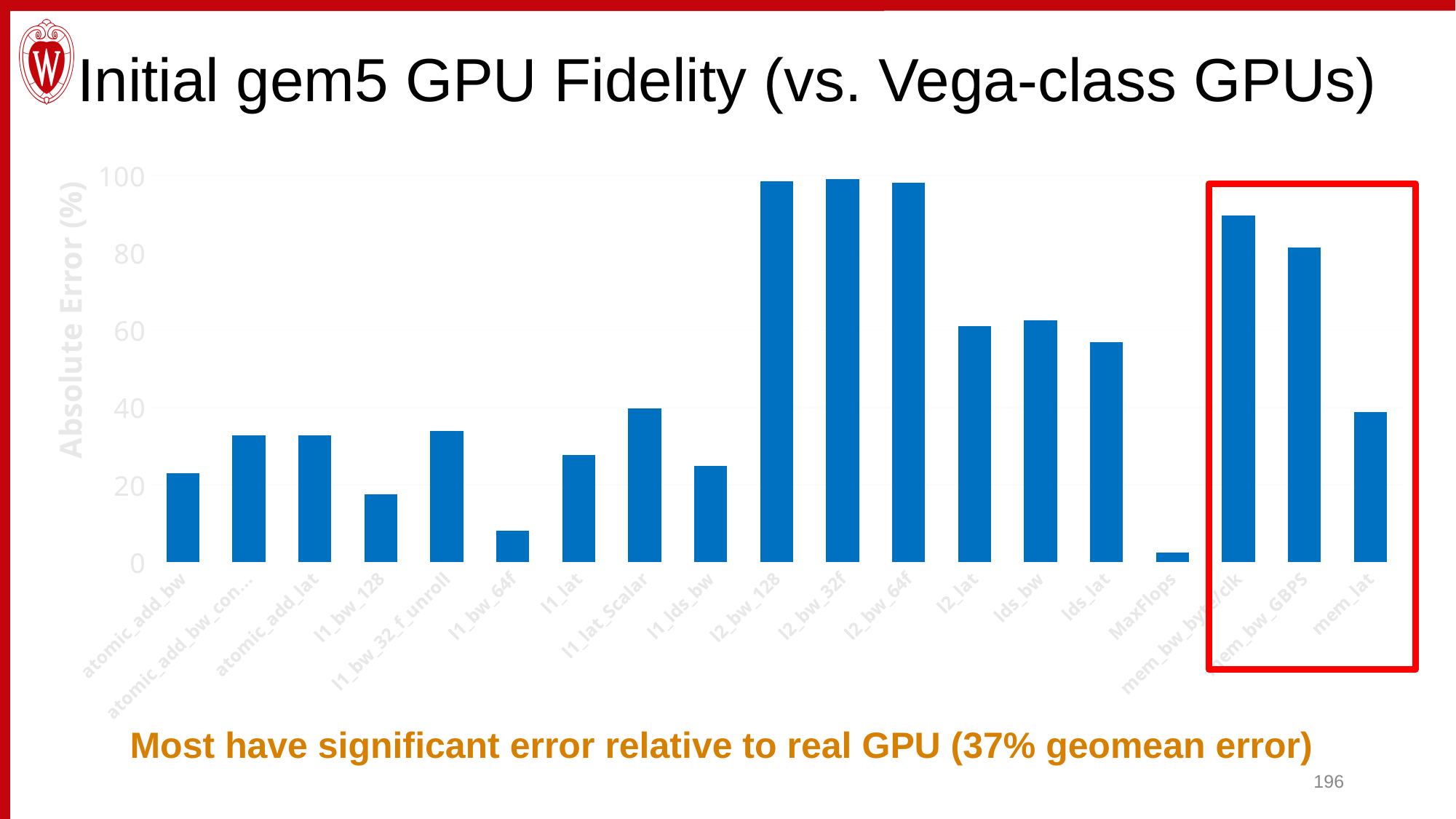
Is the value for l2_bw_32f greater or less than 80? greater Which has a larger absolute error, l1_bw_128 or l2_lat? l2_lat How many bars are enclosed by the red box on the right of the chart? 3 What is the label of the vertical axis? Absolute Error (%) Is the value for lds_lat greater or less than 40? greater How many categories (bars) are plotted in the chart? 19 Is the value for l1_lat greater or less than 40? less What kind of chart is shown on the slide? bar chart Which has a larger absolute error, mem_bw_byte/clk or mem_lat? mem_bw_byte/clk Which category has the lowest absolute error? MaxFlops